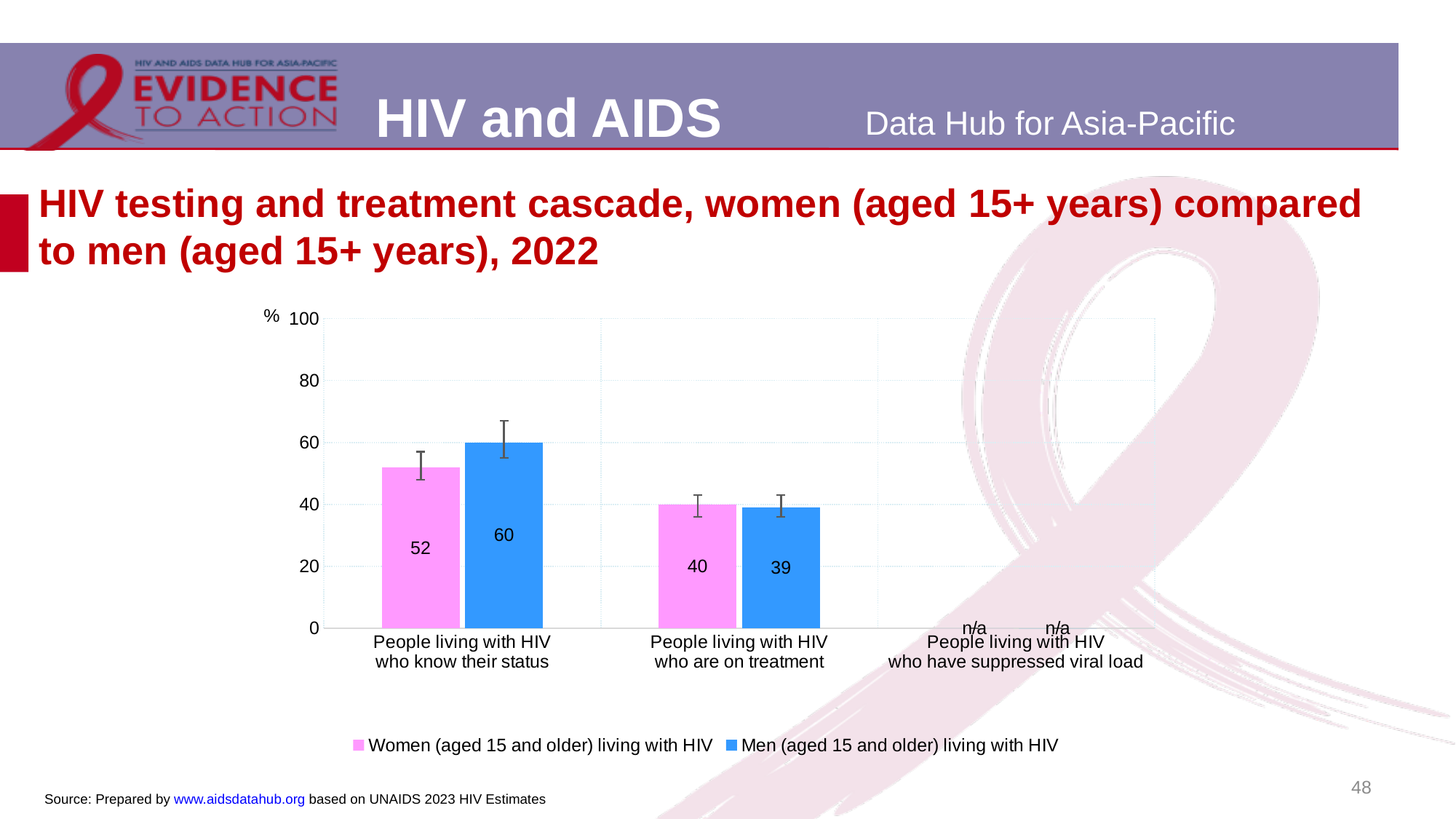
What is shown for people living with HIV who have suppressed viral load? n/a What colour represents women (aged 15 and older) living with HIV? Pink Which series has the higher value for people living with HIV who know their status, women or men? Men Which category has the highest value for men living with HIV? People living with HIV who know their status What is the value for men living with HIV who are on treatment? 39 What kind of chart is shown on the slide? Bar chart What is the value for men living with HIV who know their status? 60 How many series does the legend list? 2 What is the value for women living with HIV who know their status? 52 What is the value for women living with HIV who are on treatment? 40 What is the difference between the men's and women's values for people living with HIV who know their status? 8 What is the difference between the women's and men's values for people living with HIV who are on treatment? 1